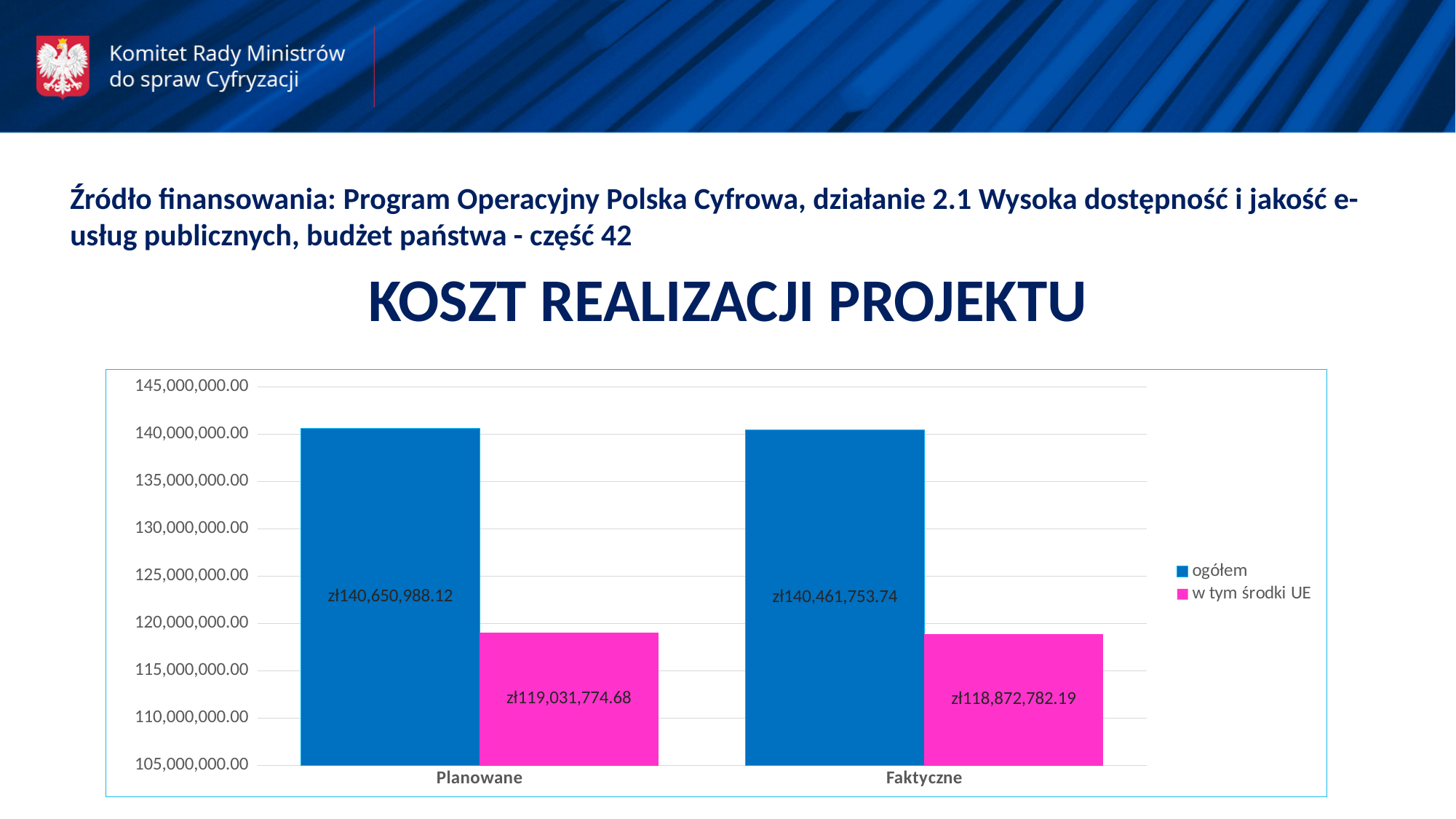
Which bar has the lowest value on the chart? w tym środki UE for Faktyczne How many series does the legend list? 2 What is the difference between ogółem and w tym środki UE for Planowane? zł21,619,213.44 Is the value of w tym środki UE for Planowane greater or less than 120,000,000.00? less What is the value of ogółem for Faktyczne? zł140,461,753.74 What is the value of w tym środki UE for Planowane? zł119,031,774.68 What is the value of ogółem for Planowane? zł140,650,988.12 How many categories are shown on the x axis? 2 What is the difference between ogółem for Planowane and ogółem for Faktyczne? zł189,234.38 Which bar has the highest value on the chart? ogółem for Planowane What type of chart is shown on the slide? bar chart What is the value of w tym środki UE for Faktyczne? zł118,872,782.19